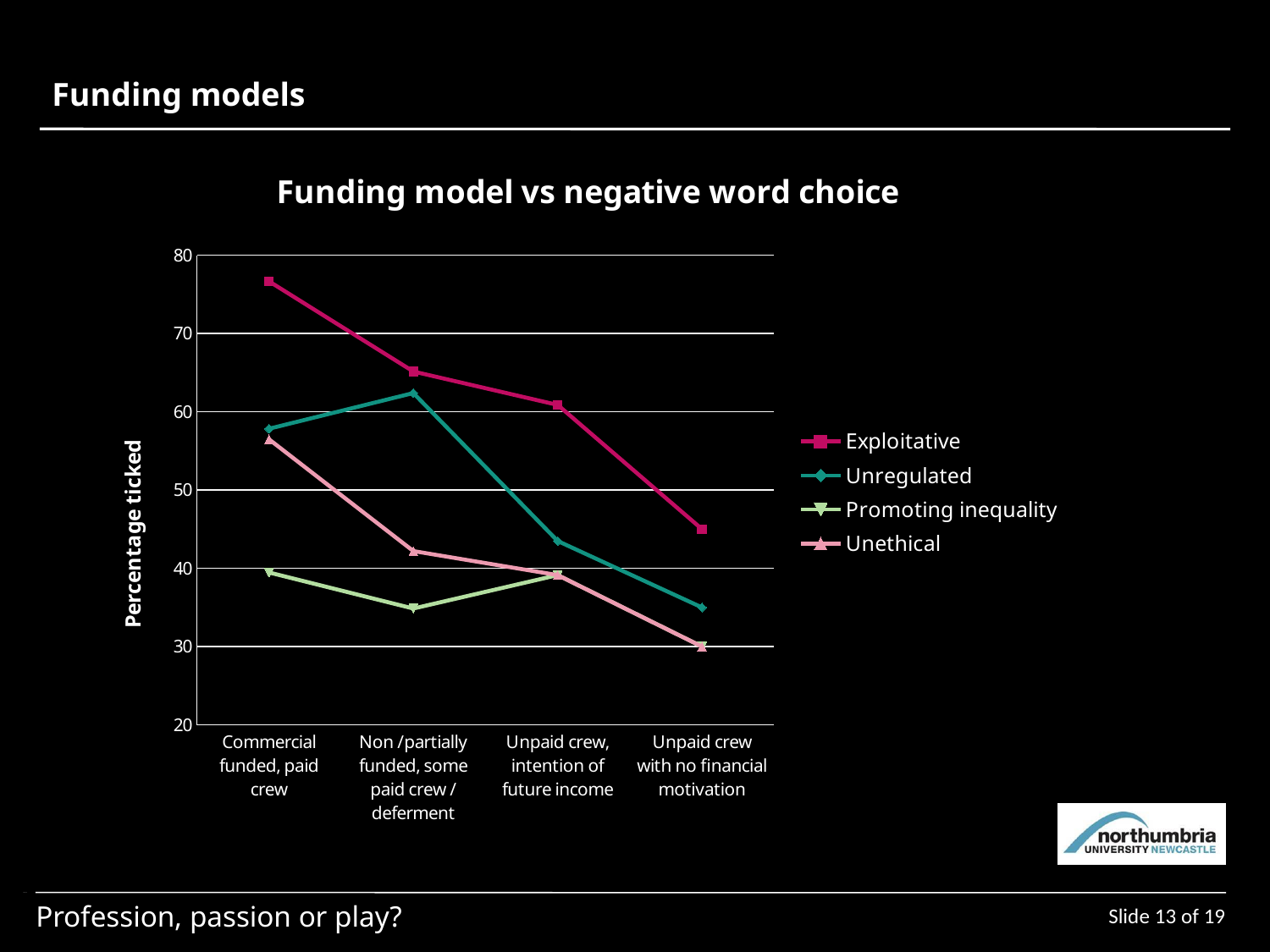
What kind of chart is shown on the slide? line chart Is the Unethical value for 'Commercial funded, paid crew' greater or less than 50? greater What is the label on the vertical axis of the chart? Percentage ticked Is the Exploitative value for 'Unpaid crew with no financial motivation' greater or less than 50? less Is the Exploitative value for 'Commercial funded, paid crew' greater or less than 70? greater Does the Exploitative series rise or fall from left to right across the x axis? fall How many series does the legend list? 4 How many funding model categories are shown on the x axis? 4 Which series has the lowest value for 'Commercial funded, paid crew'? Promoting inequality Which series has the highest value for 'Commercial funded, paid crew'? Exploitative For 'Non /partially funded, some paid crew / deferment', which is larger: the Unregulated value or the Unethical value? Unregulated